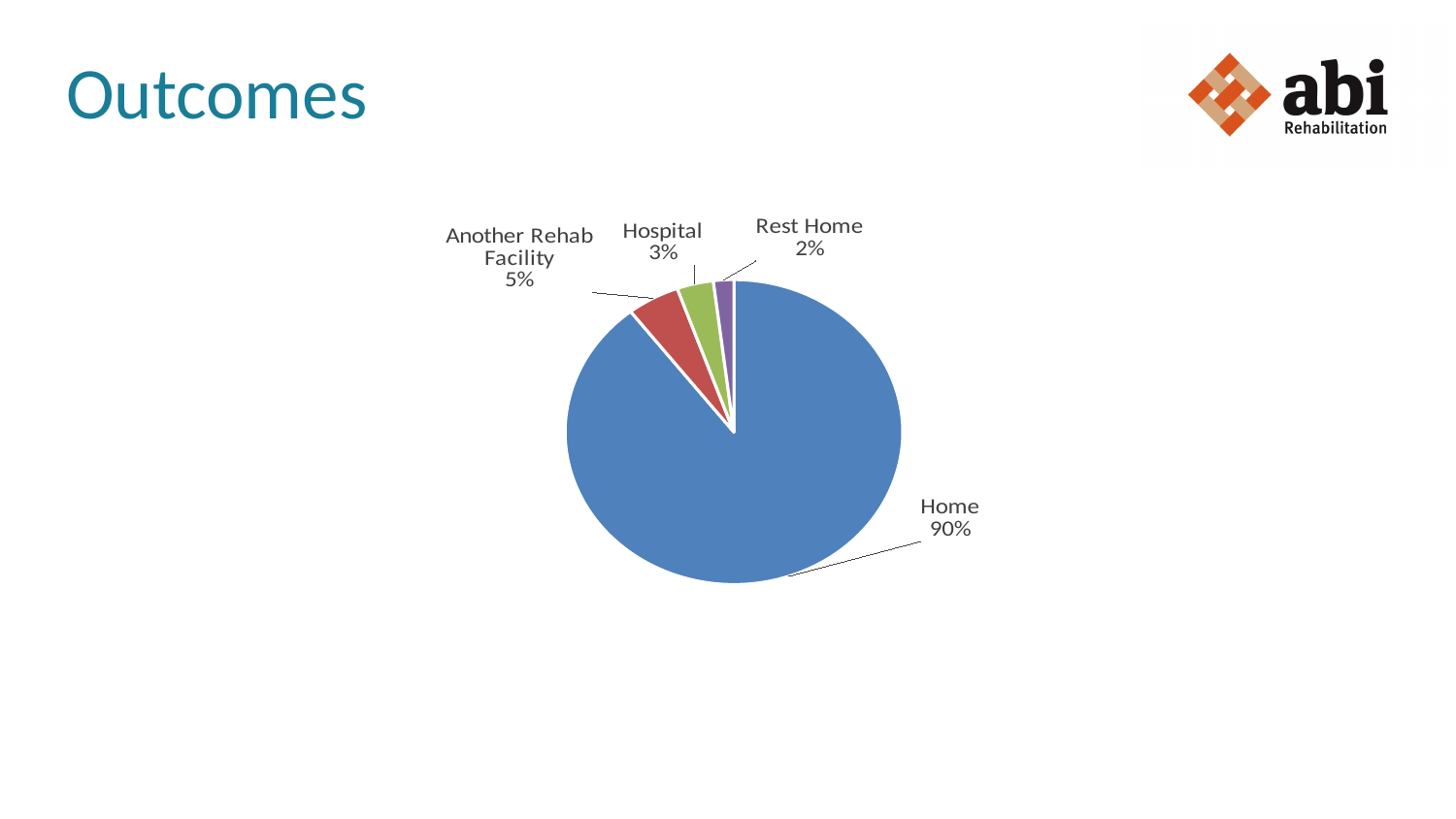
How many categories are shown in the pie chart? 4 What is the title of the slide containing the chart? Outcomes What kind of chart is shown on the slide? Pie chart What is the difference in percentage points between Hospital and Rest Home? 1 What percentage is shown for Hospital? 3% What share of the pie does Home account for? 90% What percentage is shown for Rest Home? 2% Which category has the largest slice of the pie? Home What is the difference in percentage points between Home and Another Rehab Facility? 85 Which category has the smallest slice of the pie? Rest Home What percentage is shown for Another Rehab Facility? 5% Which is larger, the share for Another Rehab Facility or the share for Hospital? Another Rehab Facility